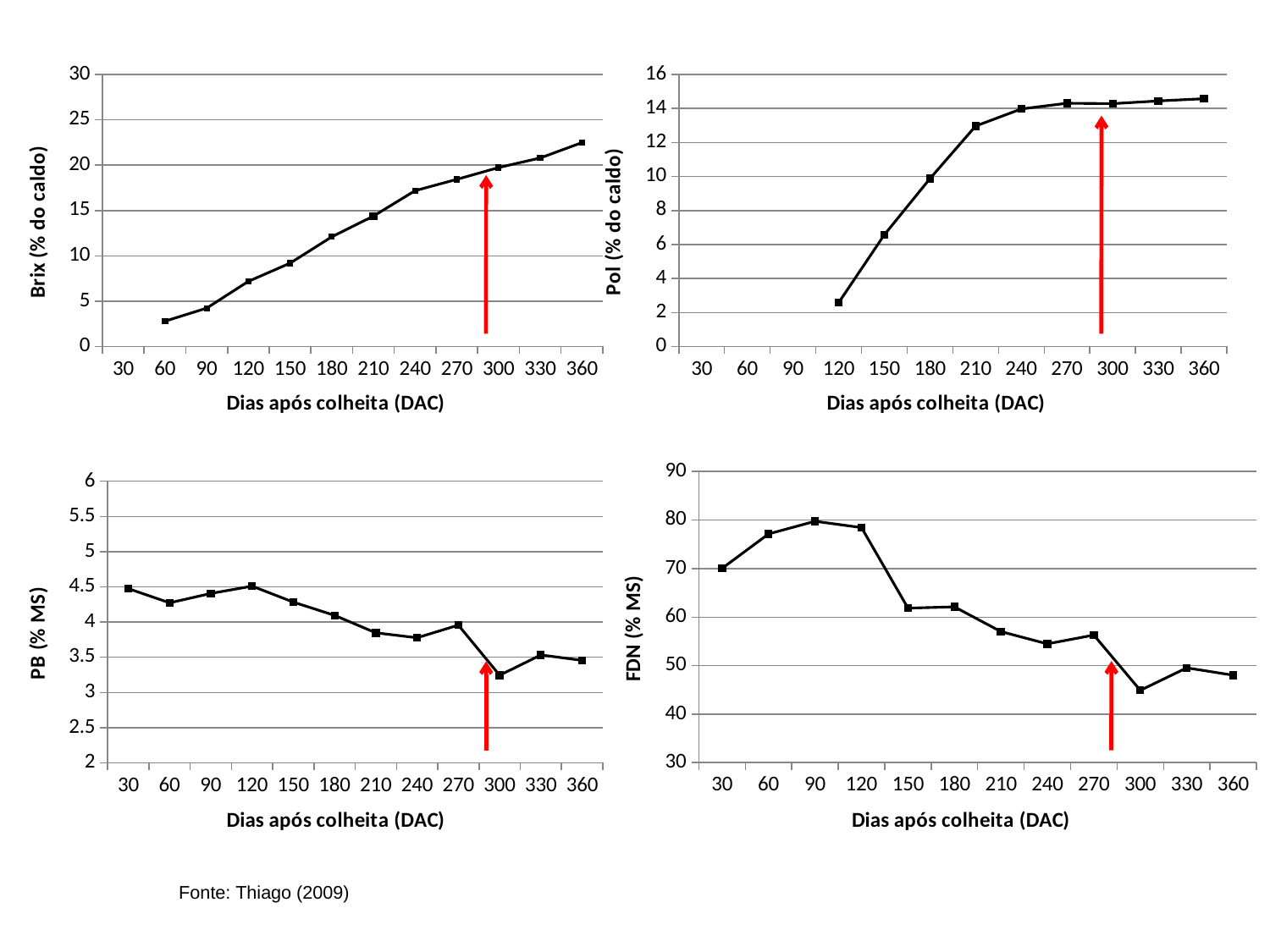
In the bottom-right chart (FDN), at which DAC is the value highest? 90 In the top-left chart (Brix), is the value at 360 DAC greater or less than 20? greater What is the x-axis label of the bottom-right chart (FDN)? Dias após colheita (DAC) What kind of chart is the top-left chart (Brix)? line chart In the bottom-left chart (PB), do the values generally rise or fall as days after harvest increase? fall In the top-left chart (Brix), at which DAC is the value lowest? 60 In the top-right chart (Pol), at which DAC is the value highest? 360 In the top-right chart (Pol), is the value at 120 DAC greater or less than 4? less In the top-left chart (Brix), do the values rise or fall as days after harvest increase? rise In the bottom-left chart (PB), at which DAC is the value lowest? 300 In the bottom-right chart (FDN), is the value at 300 DAC greater or less than 50? less How many data points are plotted in the top-right chart (Pol)? 9